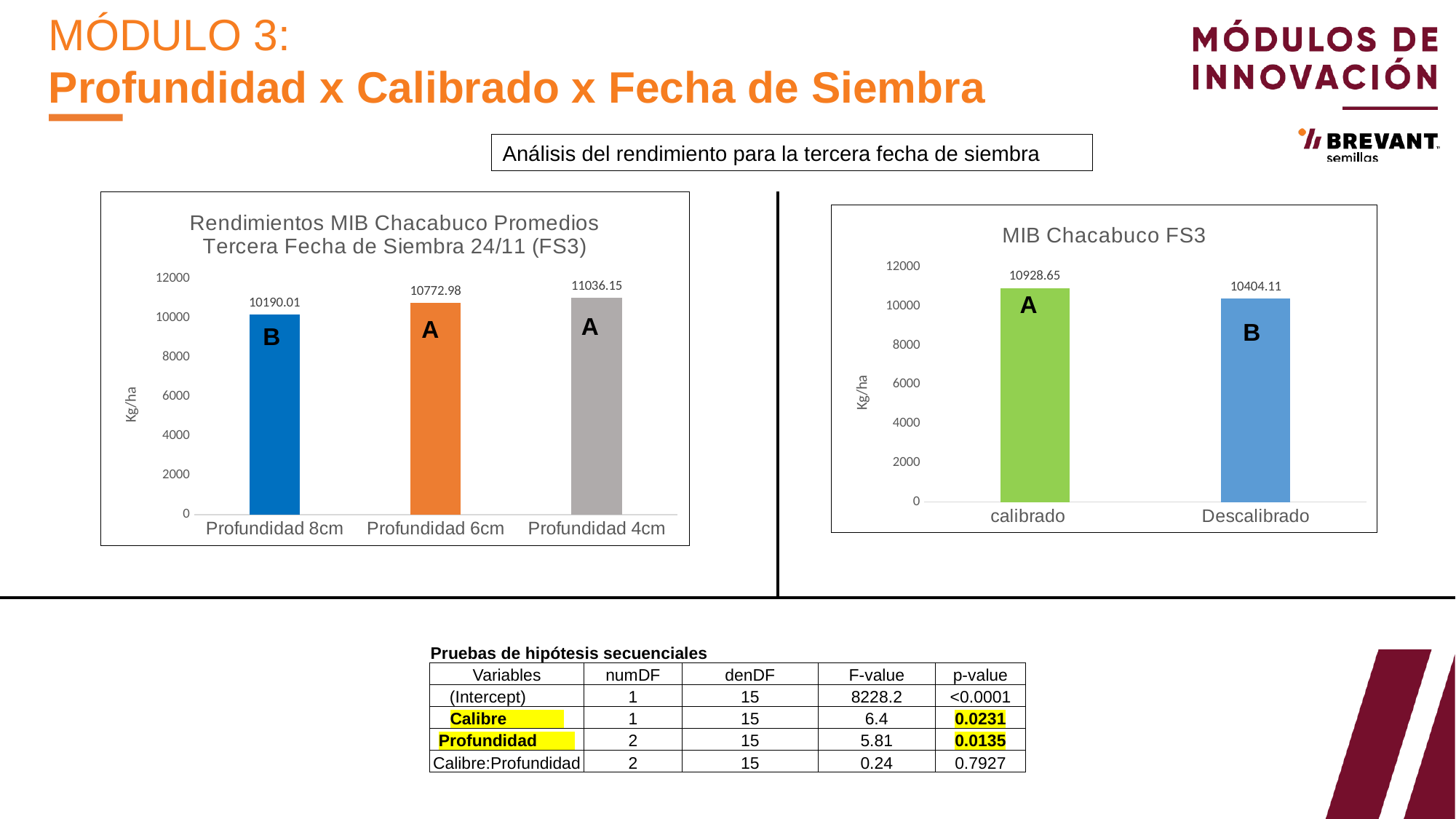
In the right chart (MIB Chacabuco FS3), which is larger, calibrado or Descalibrado? calibrado In the left chart (Rendimientos MIB Chacabuco Promedios), which category has the highest value? Profundidad 4cm In the left chart (Rendimientos MIB Chacabuco Promedios), what is the value for Profundidad 6cm? 10772.98 In the left chart (Rendimientos MIB Chacabuco Promedios), what is the value for Profundidad 8cm? 10190.01 In the right chart (MIB Chacabuco FS3), what is the difference between calibrado and Descalibrado? 524.54 In the left chart (Rendimientos MIB Chacabuco Promedios), do the values rise or fall from Profundidad 8cm to Profundidad 4cm? rise In the right chart (MIB Chacabuco FS3), what is the value for Descalibrado? 10404.11 In the left chart (Rendimientos MIB Chacabuco Promedios), which category has the lowest value? Profundidad 8cm In the left chart (Rendimientos MIB Chacabuco Promedios), how many categories are plotted? 3 In the left chart (Rendimientos MIB Chacabuco Promedios), what is the difference between Profundidad 4cm and Profundidad 8cm? 846.14 In the right chart (MIB Chacabuco FS3), what is the value for calibrado? 10928.65 What kind of chart is the right chart (MIB Chacabuco FS3)? bar chart